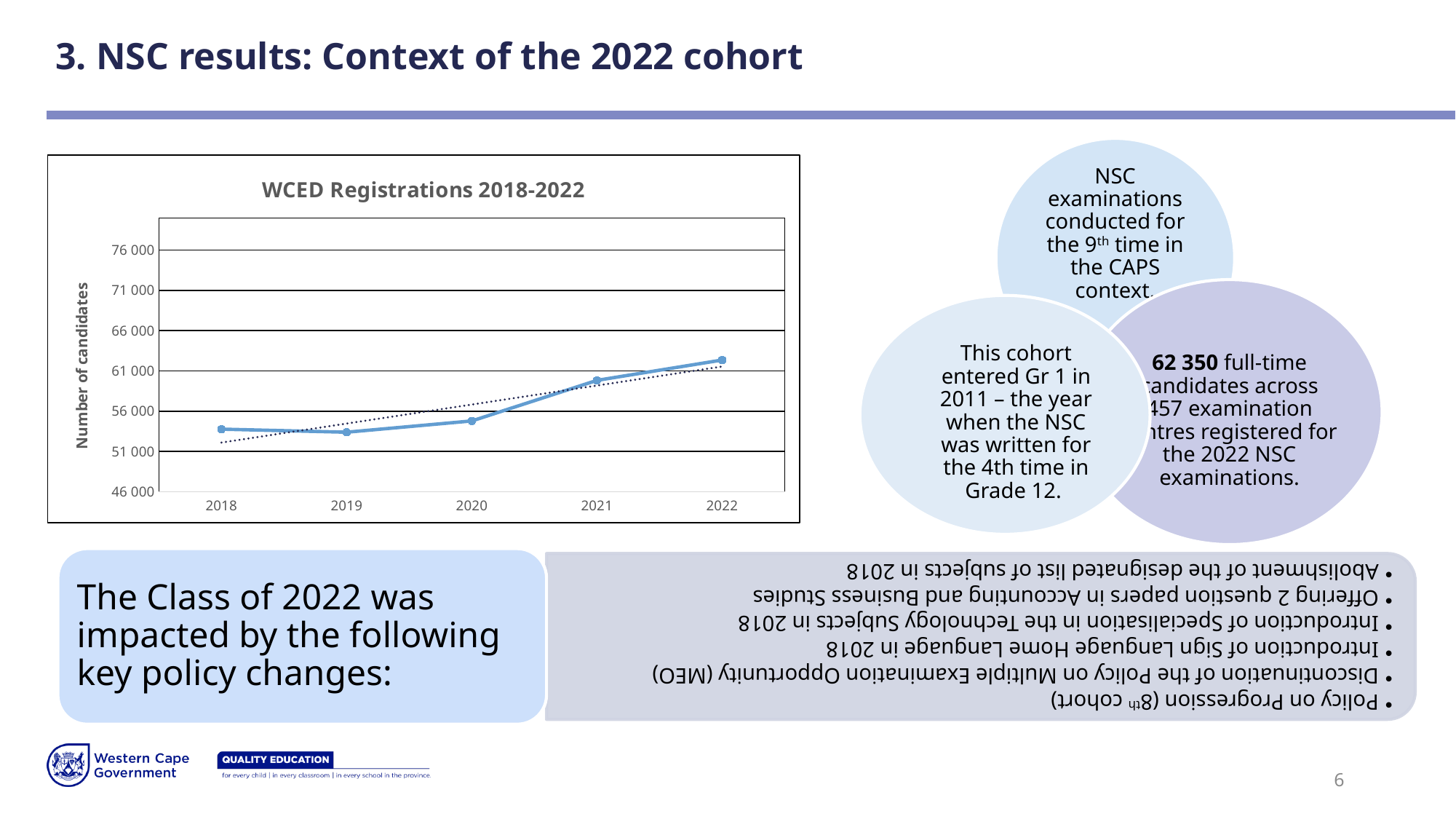
Is the value for 2018 greater or less than 51 000? greater What is the title of the chart? WCED Registrations 2018-2022 Is the value for 2022 greater or less than 61 000? greater Which year has more candidates, 2018 or 2022? 2022 What is the label of the vertical axis of the chart? Number of candidates Is the value for 2020 greater or less than 56 000? less Which year has more candidates, 2020 or 2021? 2021 How many years are plotted on the x axis of the chart? 5 Which year has the highest number of candidates in the chart? 2022 Do the registrations generally rise or fall from 2018 to 2022? rise What kind of chart is shown on the slide? line chart